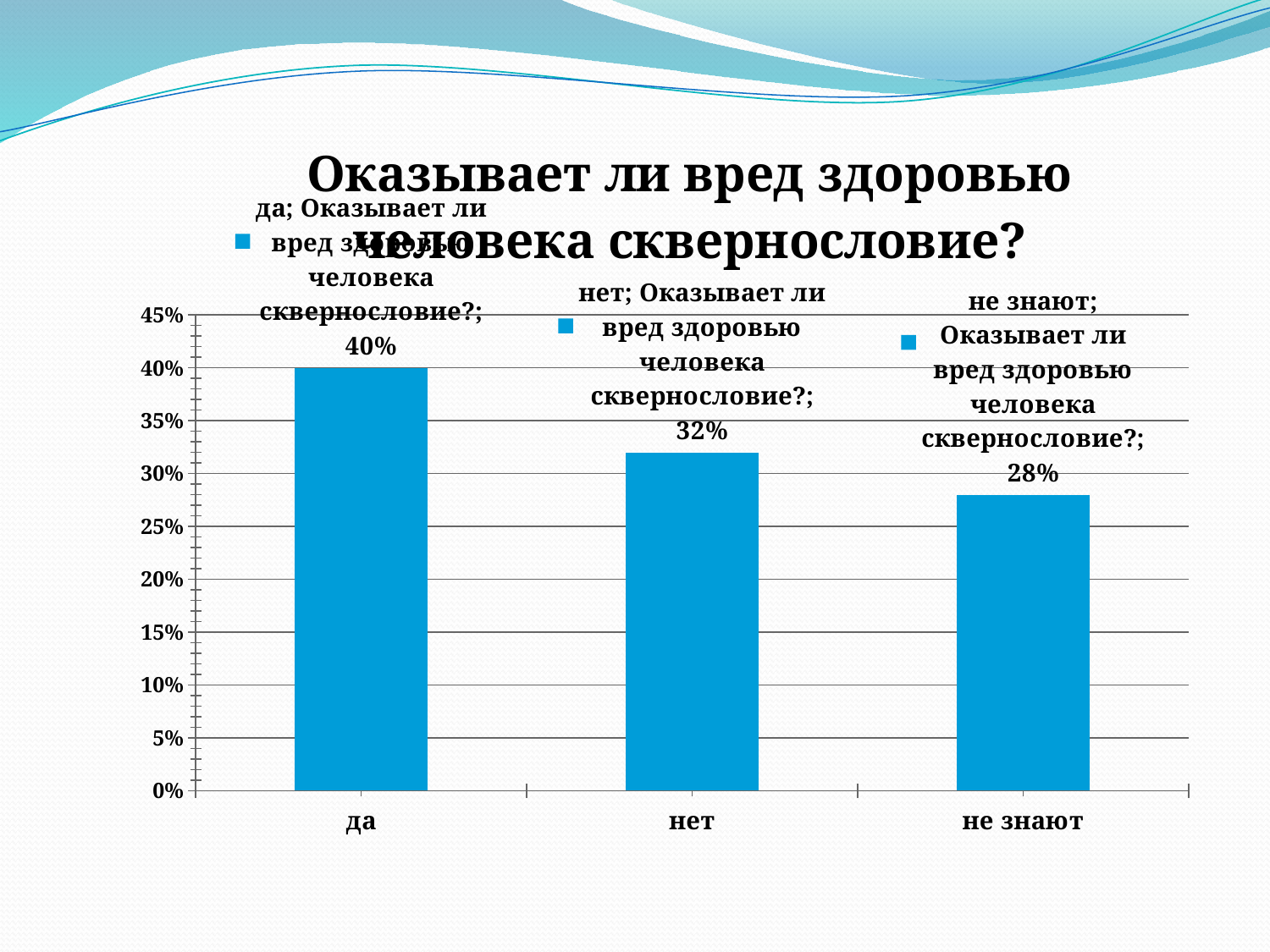
What is the difference between the values for "нет" and "не знают"? 4% What is the value for "нет"? 32% Do the values rise or fall from left to right along the x axis? fall Which is larger, the value for "да" or the value for "не знают"? да What is the difference between the values for "да" and "нет"? 8% What is the value for "не знают"? 28% What is the value for "да"? 40% How many categories are shown on the x axis? 3 Is the value for "нет" greater or less than 30%? greater Which category has the lowest value? не знают What kind of chart is shown on the slide? bar chart Which category has the highest value? да